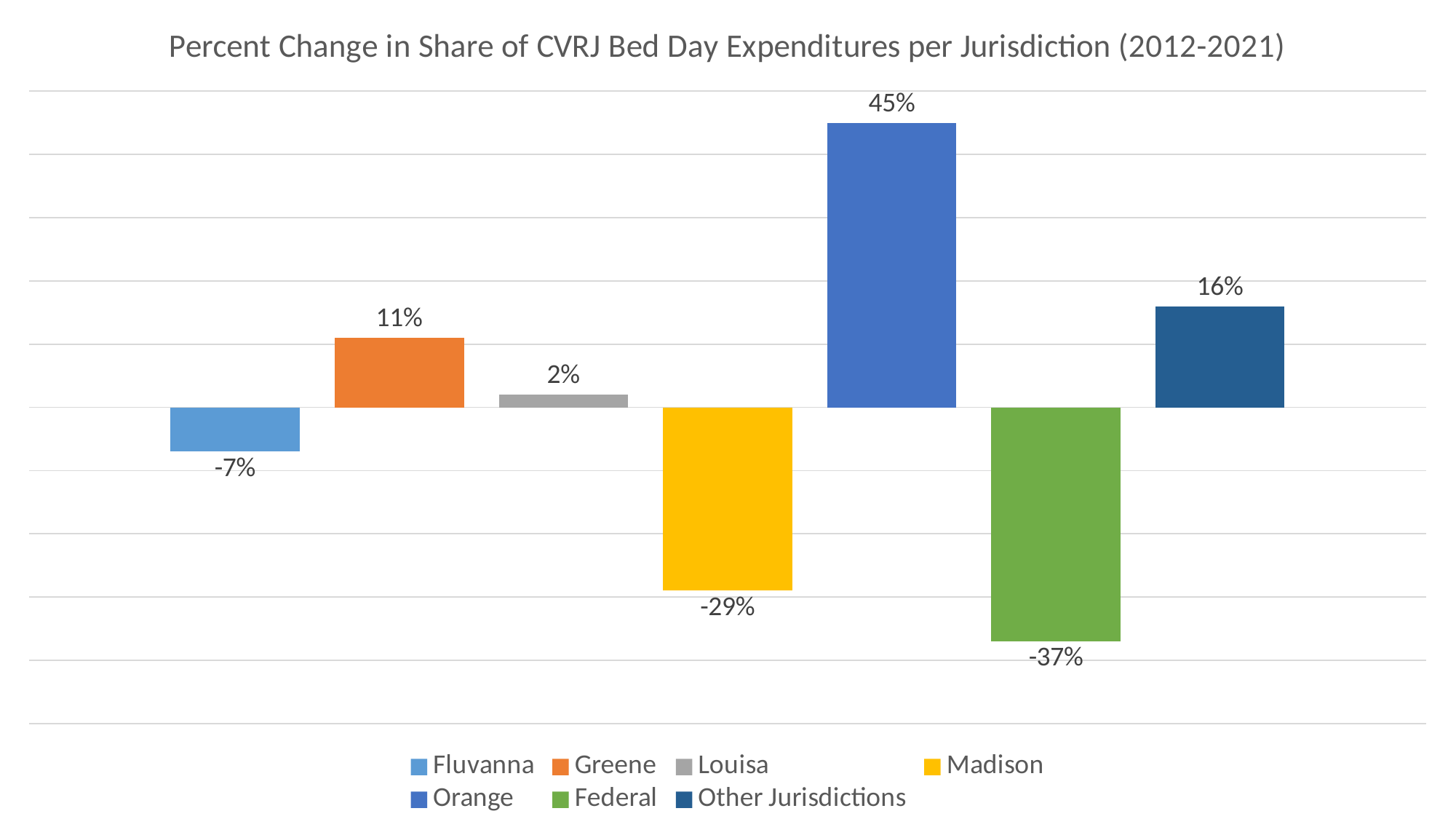
What type of chart is shown? Bar chart What colour is the bar for Madison? Yellow Which jurisdiction has the highest percent change? Orange What is the difference between the percent change for Orange and for Greene? 34 percentage points What is the percent change for Orange? 45% What is the percent change for Madison? -29% What is the percent change for Fluvanna? -7% Which has a larger percent change, Greene or Louisa? Greene Which jurisdiction has the lowest percent change? Federal What is the percent change for Other Jurisdictions? 16% How many entries does the legend list? 7 How many jurisdictions are shown in the chart? 7